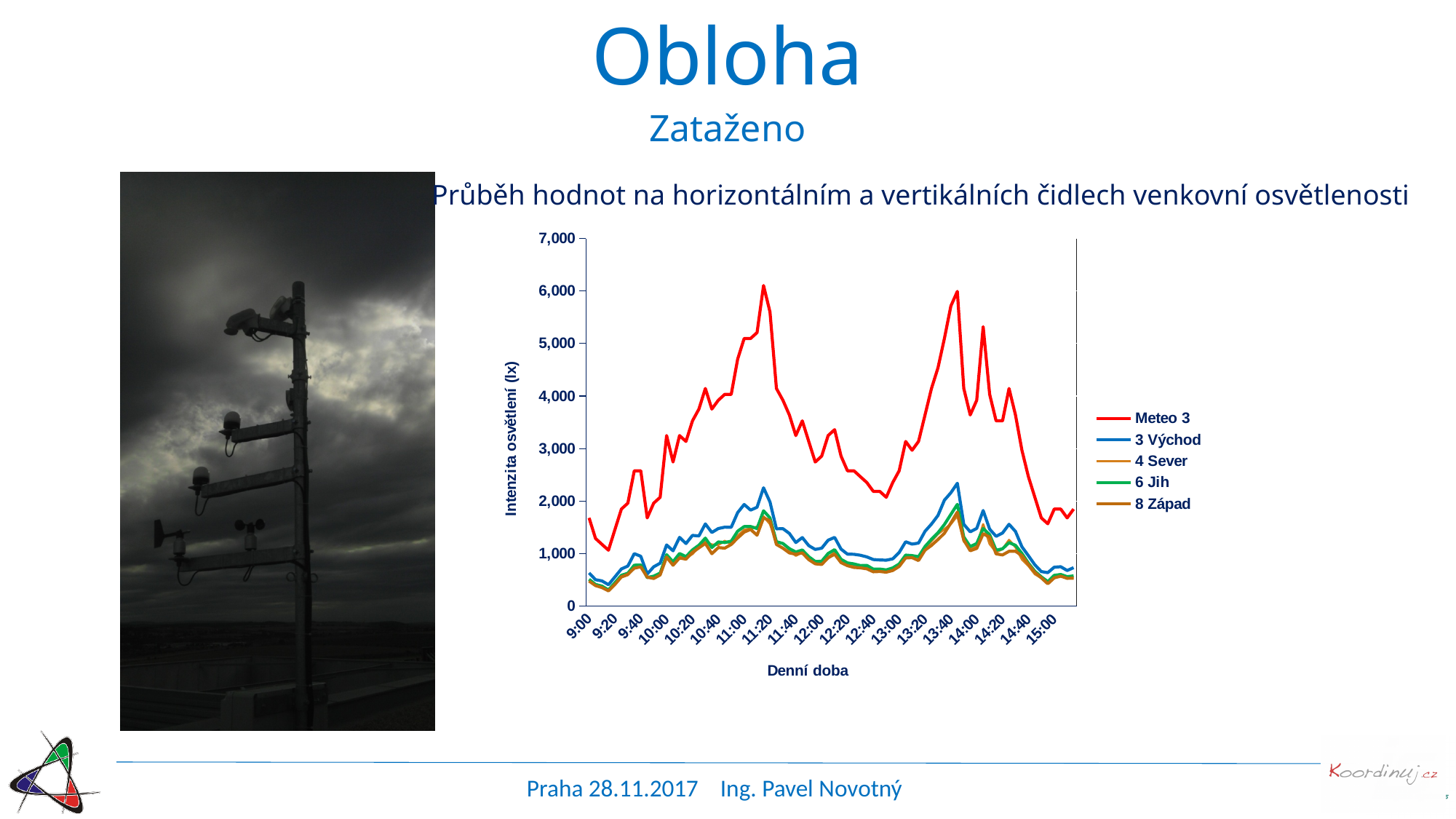
How many time labels are shown on the x axis? 19 Which series reaches the highest values on the chart? Meteo 3 What is the label of the y axis of the chart? Intenzita osvětlení (lx) Is the peak value of the Meteo 3 series greater or less than 5,000? greater Is the value of 3 Východ at 9:00 greater or less than 1,000? less Is the value of Meteo 3 at 12:40 greater or less than 2,000? greater At 11:00, which series has the larger value, Meteo 3 or 3 Východ? Meteo 3 How many series does the chart legend list? 5 What is the title of the chart? Průběh hodnot na horizontálním a vertikálních čidlech venkovní osvětlenosti What kind of chart is shown on the slide? Line chart Does the Meteo 3 series rise or fall between 9:40 and 11:20? rise